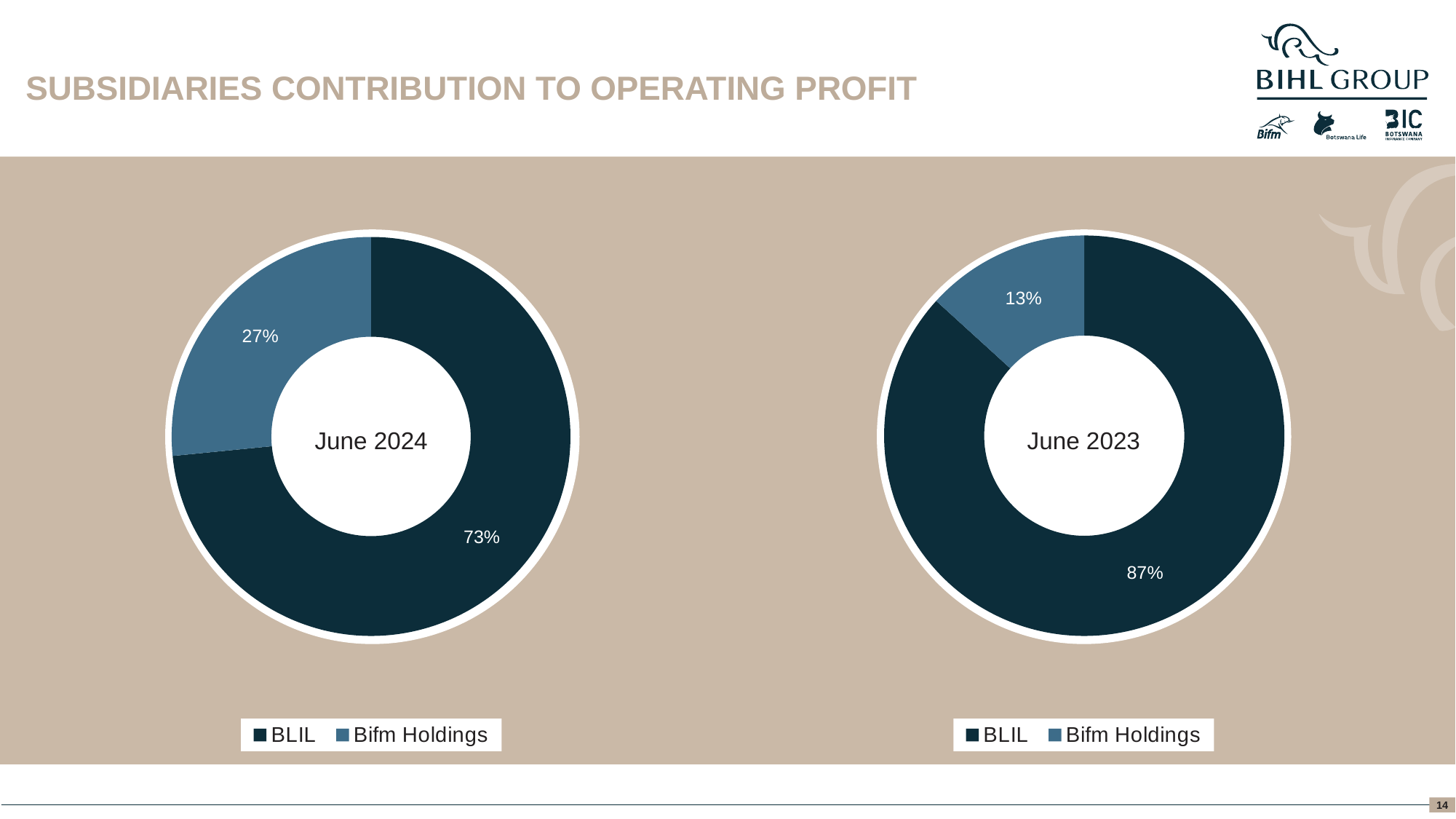
In the June 2023 chart, what share of operating profit does BLIL contribute? 87% How many entries does the legend of the June 2023 chart list? 2 In the June 2024 chart, what share of operating profit does Bifm Holdings contribute? 27% In the June 2023 chart, which subsidiary has the smallest share? Bifm Holdings What kind of chart is the June 2024 chart? Pie chart (doughnut) In the June 2024 chart, what is the difference between the BLIL share and the Bifm Holdings share? 46% What is the title of the slide containing the two charts? SUBSIDIARIES CONTRIBUTION TO OPERATING PROFIT In the June 2023 chart, what share of operating profit does Bifm Holdings contribute? 13% In the June 2023 chart, what is the difference between the BLIL share and the Bifm Holdings share? 74% Is the Bifm Holdings share larger in the June 2024 chart or the June 2023 chart? June 2024 In the June 2024 chart, which subsidiary has the largest share? BLIL